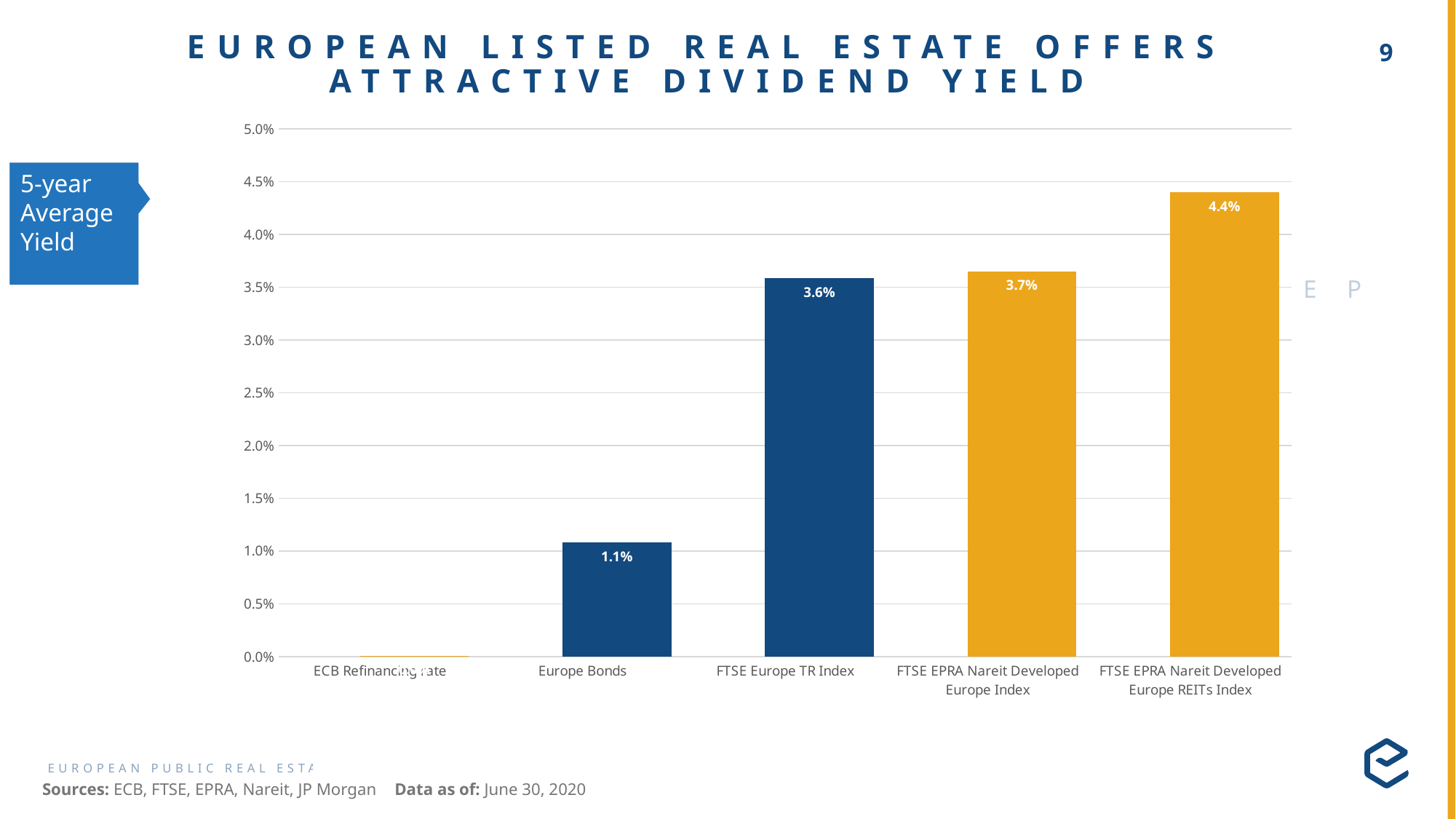
Which category has the lowest yield on the chart? ECB Refinancing rate What value is shown for the FTSE EPRA Nareit Developed Europe REITs Index? 4.4% What does the blue callout box to the left of the chart say? 5-year Average Yield What value is shown for the FTSE Europe TR Index? 3.6% Which category has the highest yield on the chart? FTSE EPRA Nareit Developed Europe REITs Index How many categories are shown on the x axis of the chart? 5 What is the difference between the yield of the FTSE EPRA Nareit Developed Europe REITs Index and Europe Bonds? 3.3% What kind of chart is shown on the slide? Bar chart What is the 5-year average yield shown for Europe Bonds? 1.1% Is the value for the ECB Refinancing rate greater or less than 0.5%? less Which is larger, the yield for Europe Bonds or for the FTSE Europe TR Index? FTSE Europe TR Index What value is shown for the FTSE EPRA Nareit Developed Europe Index? 3.7%